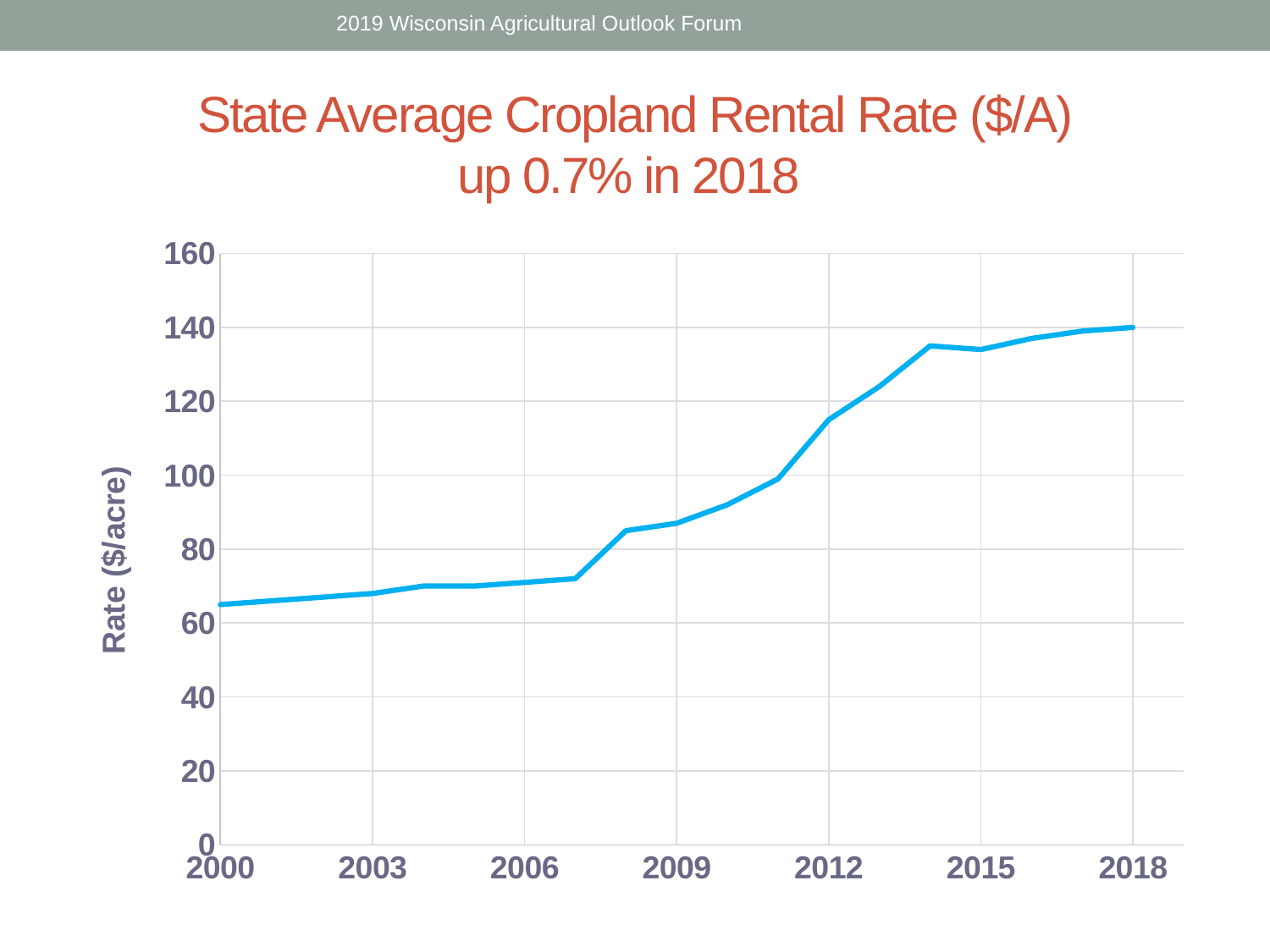
Is the value for 2006 greater or less than 80? less Is the value for 2015 greater or less than 120? greater Which year has a higher rental rate, 2009 or 2012? 2012 Which year has the highest cropland rental rate? 2018 Is the value for 2009 greater or less than 100? less By what percentage did the rental rate rise in 2018, according to the chart title? 0.7% Do the rental rates generally rise or fall from 2000 to 2018? rise Which year has the lowest cropland rental rate? 2000 What is the label on the y axis? Rate ($/acre) What kind of chart is shown on the slide? line chart